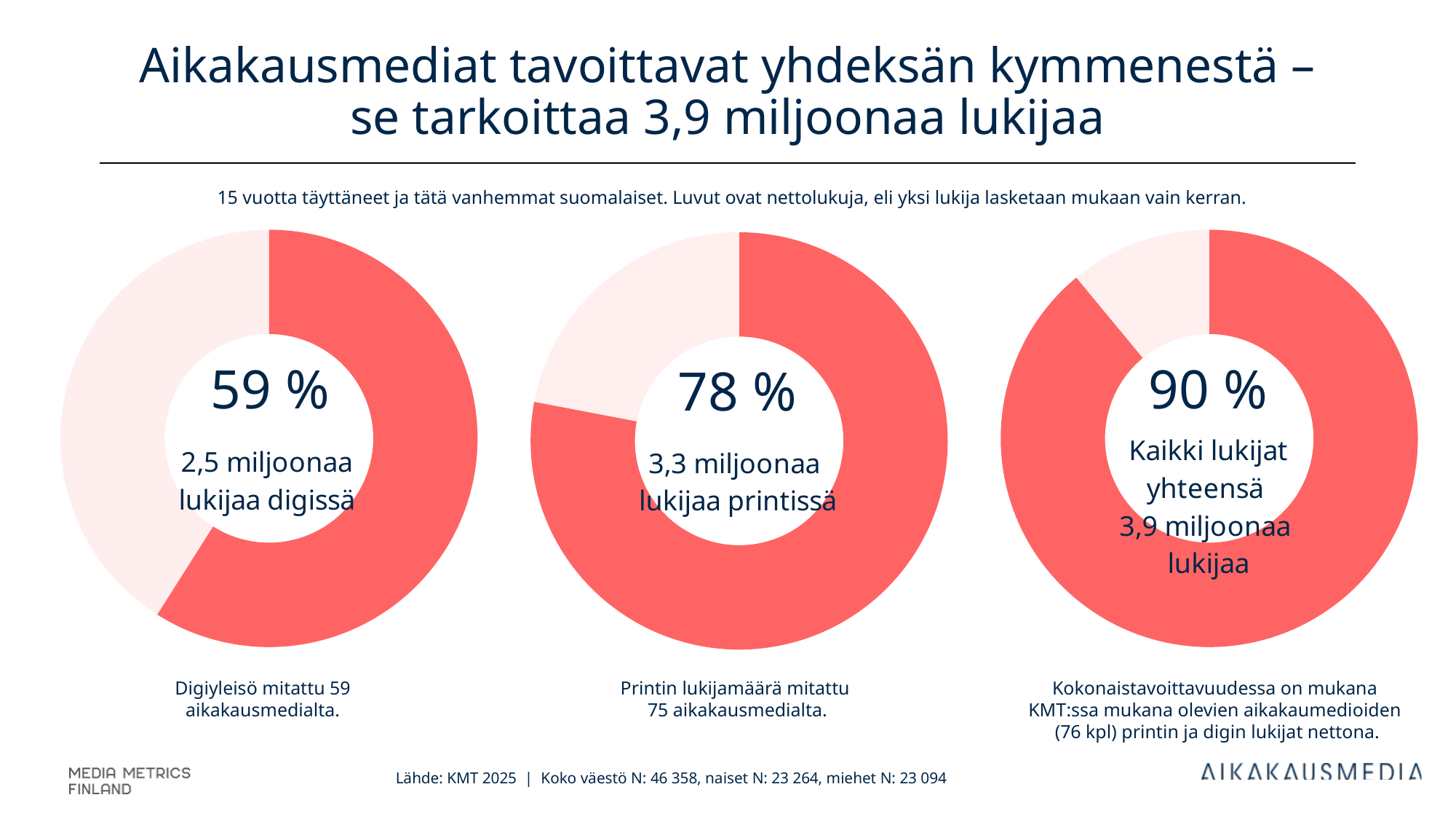
According to the middle donut chart, how many readers are there in print (printissä)? 3,3 miljoonaa What percentage is shown in the centre of the right donut chart? 90 % Which donut chart shows the highest percentage? The right chart (90 %) How many donut charts are on the slide? 3 What colour is the filled (highlighted) segment in each donut chart? Red (coral) Which is larger, the digital reach in the left chart or the print reach in the middle chart? Print reach (78 %) What kind of charts are shown on the slide? Donut (pie) charts What percentage is shown in the centre of the middle donut chart? 78 % What percentage is shown in the centre of the left donut chart? 59 % According to the right donut chart, how many readers are there in total (Kaikki lukijat yhteensä)? 3,9 miljoonaa What is the difference in percentage points between the middle chart (78 %) and the left chart (59 %)? 19 percentage points According to the left donut chart, how many readers are there in digital (digissä)? 2,5 miljoonaa